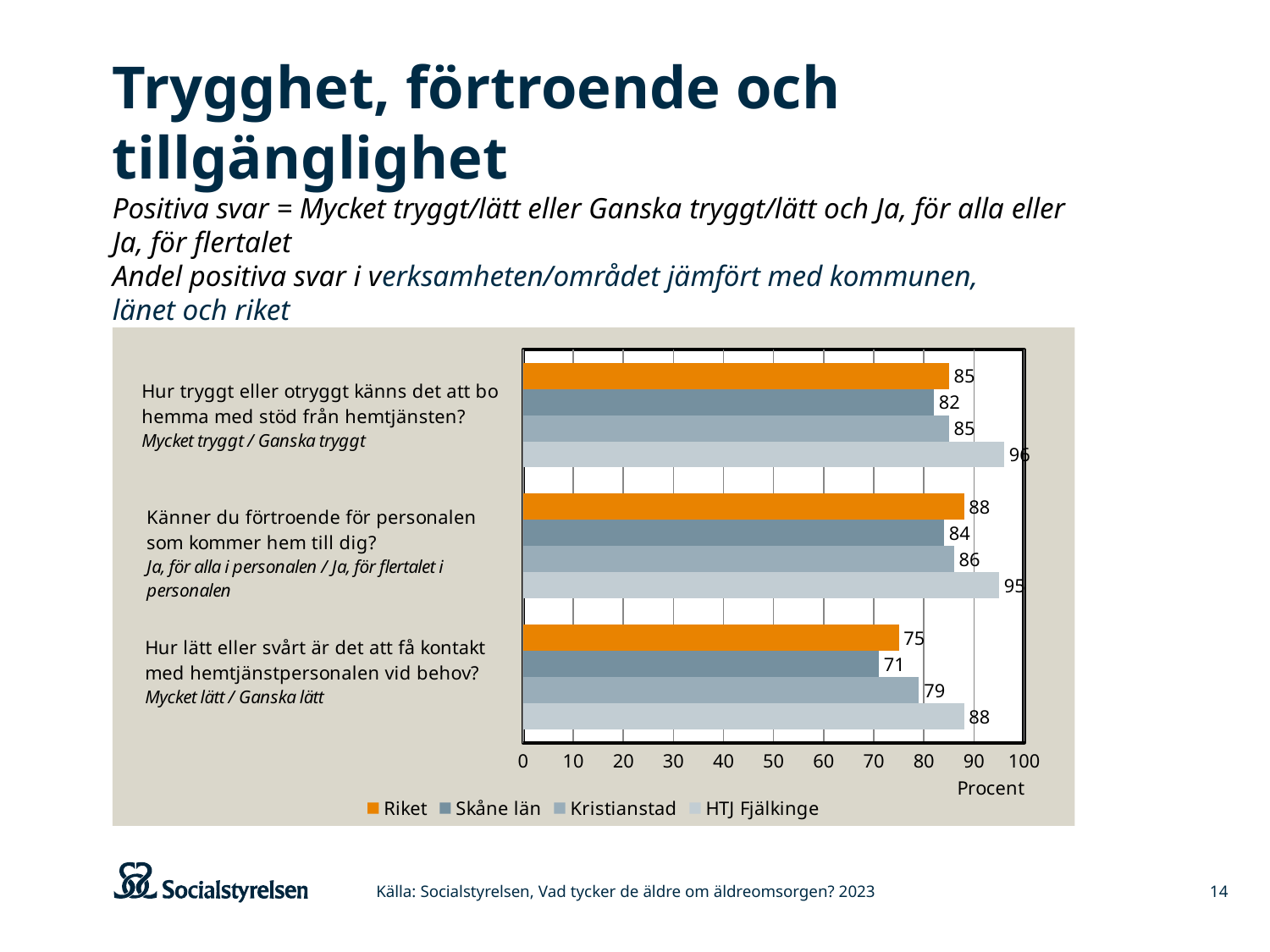
What is the value for HTJ Fjälkinge on the question 'Känner du förtroende för personalen som kommer hem till dig?' 95 Which series has the lowest value on the question 'Hur lätt eller svårt är det att få kontakt med hemtjänstpersonalen vid behov?' Skåne län Is the value for HTJ Fjälkinge on the question 'Hur tryggt eller otryggt känns det att bo hemma med stöd från hemtjänsten?' greater or less than 90? greater What kind of chart is shown on the slide? bar chart What is the difference between HTJ Fjälkinge and Riket on the question 'Hur lätt eller svårt är det att få kontakt med hemtjänstpersonalen vid behov?' 13 Which is larger on the question 'Känner du förtroende för personalen som kommer hem till dig?': Riket or Kristianstad? Riket Which series has the highest value on the question 'Känner du förtroende för personalen som kommer hem till dig?' HTJ Fjälkinge How many questions (categories) are shown on the chart? 3 How many series does the legend list? 4 What is the value for Riket on the question 'Hur lätt eller svårt är det att få kontakt med hemtjänstpersonalen vid behov?' 75 What unit is shown on the x axis of the chart? Procent What is the value for Skåne län on the question 'Hur tryggt eller otryggt känns det att bo hemma med stöd från hemtjänsten?' 82